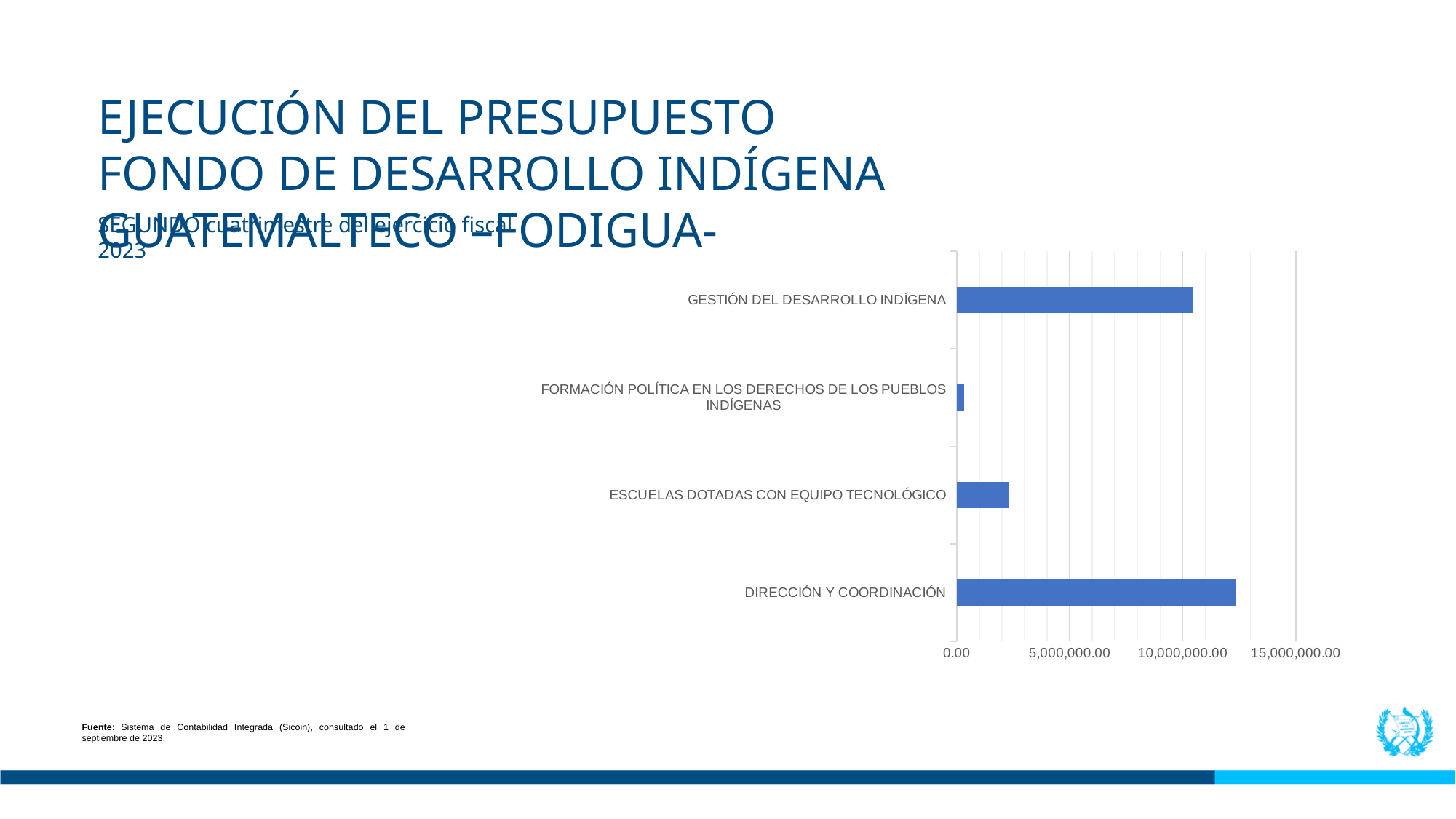
Is the value for FORMACIÓN POLÍTICA EN LOS DERECHOS DE LOS PUEBLOS INDÍGENAS greater or less than 5,000,000.00? less What colour are the bars in the chart? blue What kind of chart is shown on the slide? bar chart How many categories are plotted in the bar chart? 4 Which category has the highest value in the bar chart? DIRECCIÓN Y COORDINACIÓN Which is larger, the value for DIRECCIÓN Y COORDINACIÓN or the value for GESTIÓN DEL DESARROLLO INDÍGENA? DIRECCIÓN Y COORDINACIÓN Is the value for ESCUELAS DOTADAS CON EQUIPO TECNOLÓGICO greater or less than 5,000,000.00? less Is the value for GESTIÓN DEL DESARROLLO INDÍGENA greater or less than 15,000,000.00? less What is the highest value labelled on the horizontal axis of the bar chart? 15,000,000.00 Which category has the lowest value in the bar chart? FORMACIÓN POLÍTICA EN LOS DERECHOS DE LOS PUEBLOS INDÍGENAS Which is larger, the value for GESTIÓN DEL DESARROLLO INDÍGENA or the value for ESCUELAS DOTADAS CON EQUIPO TECNOLÓGICO? GESTIÓN DEL DESARROLLO INDÍGENA